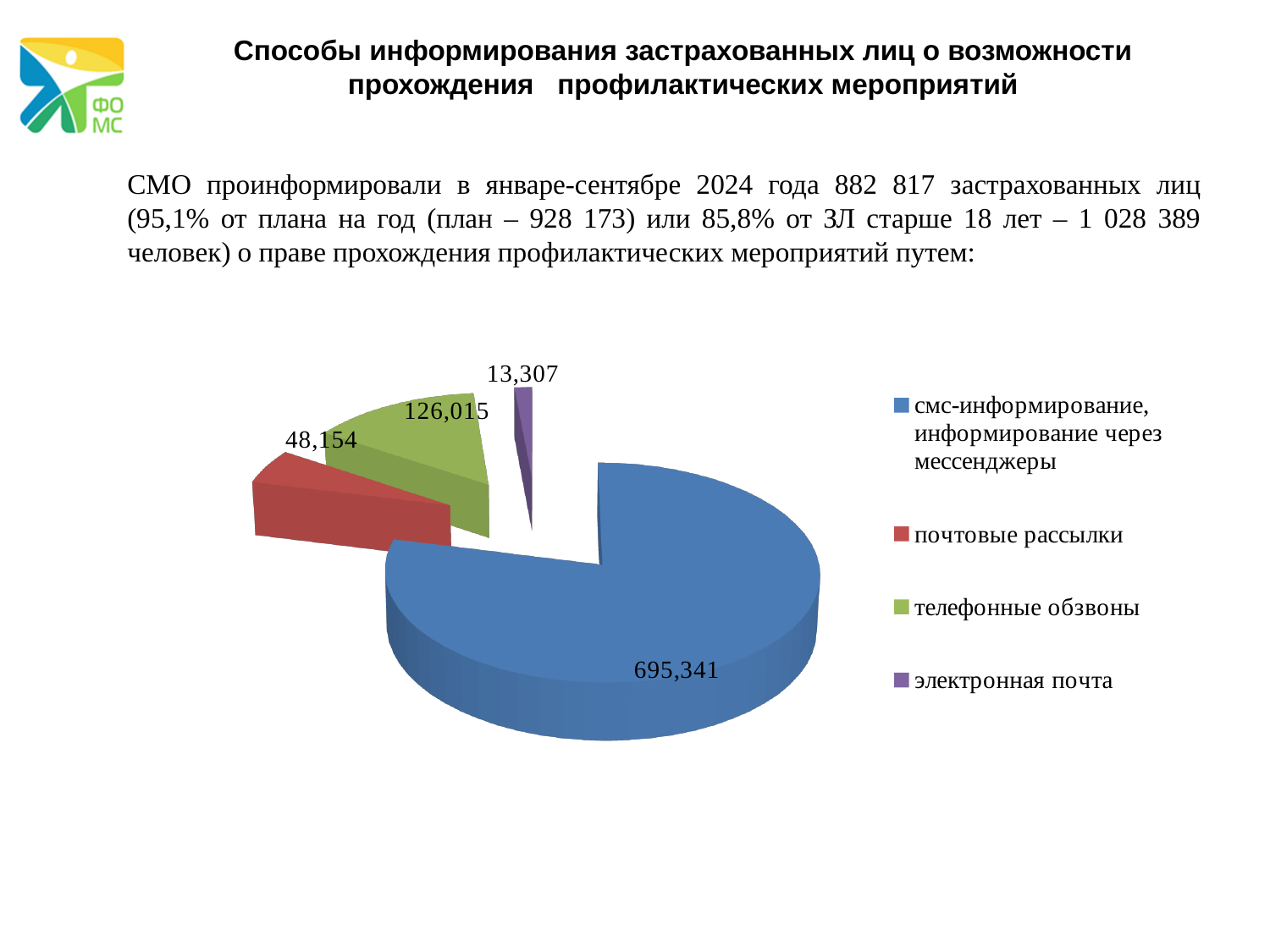
What is the value for почтовые рассылки? 48,154 What colour is the slice for телефонные обзвоны? green How many entries does the legend of the pie chart list? 4 What is the value for смс-информирование, информирование через мессенджеры? 695,341 Which category has the smallest slice of the pie? электронная почта Which category has the largest slice of the pie? смс-информирование, информирование через мессенджеры Which is larger, телефонные обзвоны or почтовые рассылки? телефонные обзвоны How many slices does the pie chart have? 4 What is the value for электронная почта? 13,307 What is the value for телефонные обзвоны? 126,015 What is the difference between the values for телефонные обзвоны and почтовые рассылки? 77,861 What type of chart is shown on the slide? pie chart